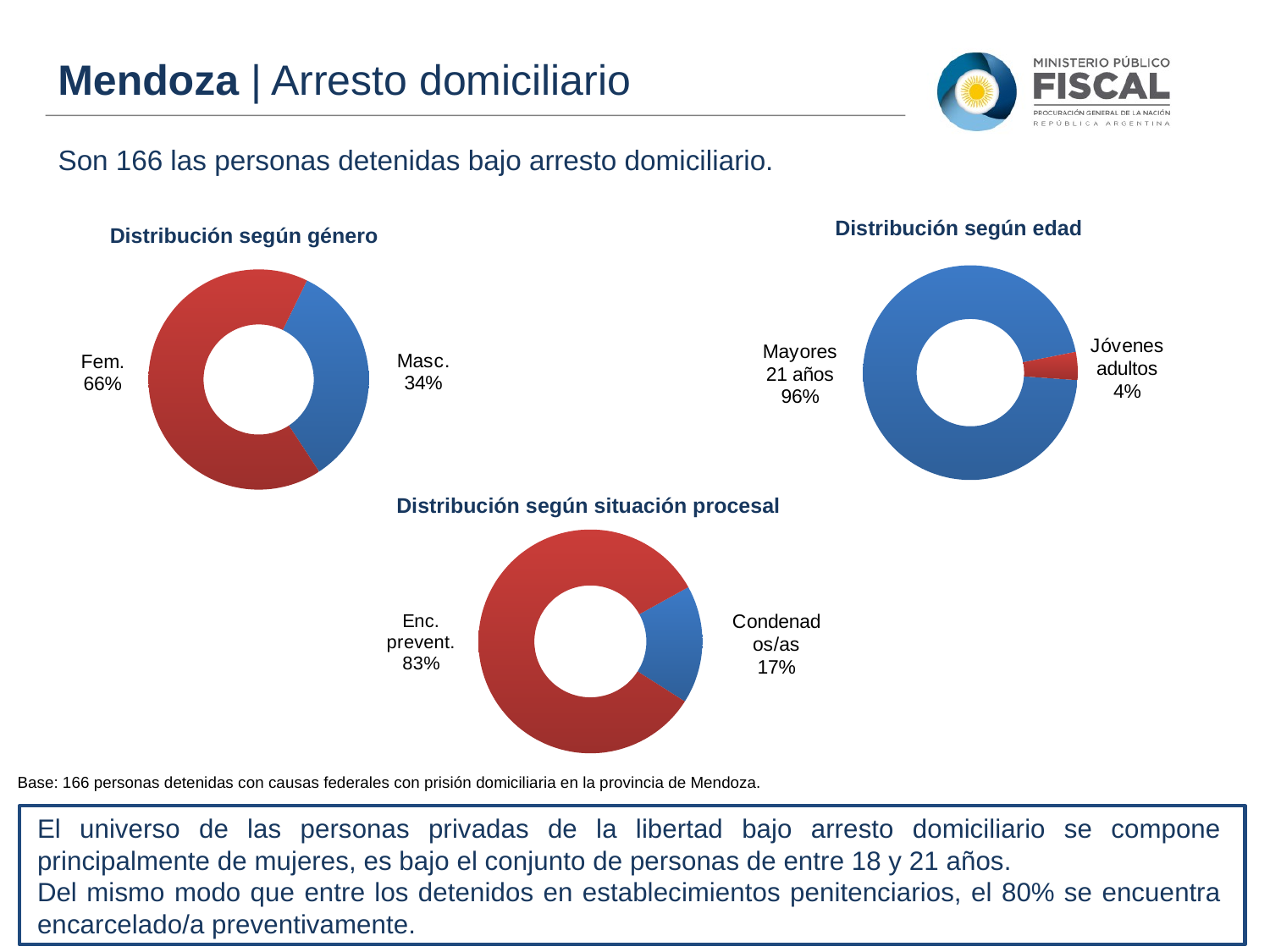
What kind of chart is 'Distribución según situación procesal'? Pie chart (donut) How many slices does the 'Distribución según edad' chart have? 2 In the 'Distribución según género' chart, what share is Fem.? 66% In the 'Distribución según edad' chart, what share is Mayores 21 años? 96% In the 'Distribución según edad' chart, which category has the smallest share? Jóvenes adultos In the 'Distribución según situación procesal' chart, what share is Condenados/as? 17% In the 'Distribución según situación procesal' chart, what share is Enc. prevent.? 83% In the 'Distribución según género' chart, what share is Masc.? 34% In the 'Distribución según género' chart, which category has the largest share? Fem. In the 'Distribución según edad' chart, what share is Jóvenes adultos? 4% In the 'Distribución según situación procesal' chart, what is the difference in percentage points between Enc. prevent. and Condenados/as? 66 In the 'Distribución según género' chart, which is larger, Fem. or Masc.? Fem.